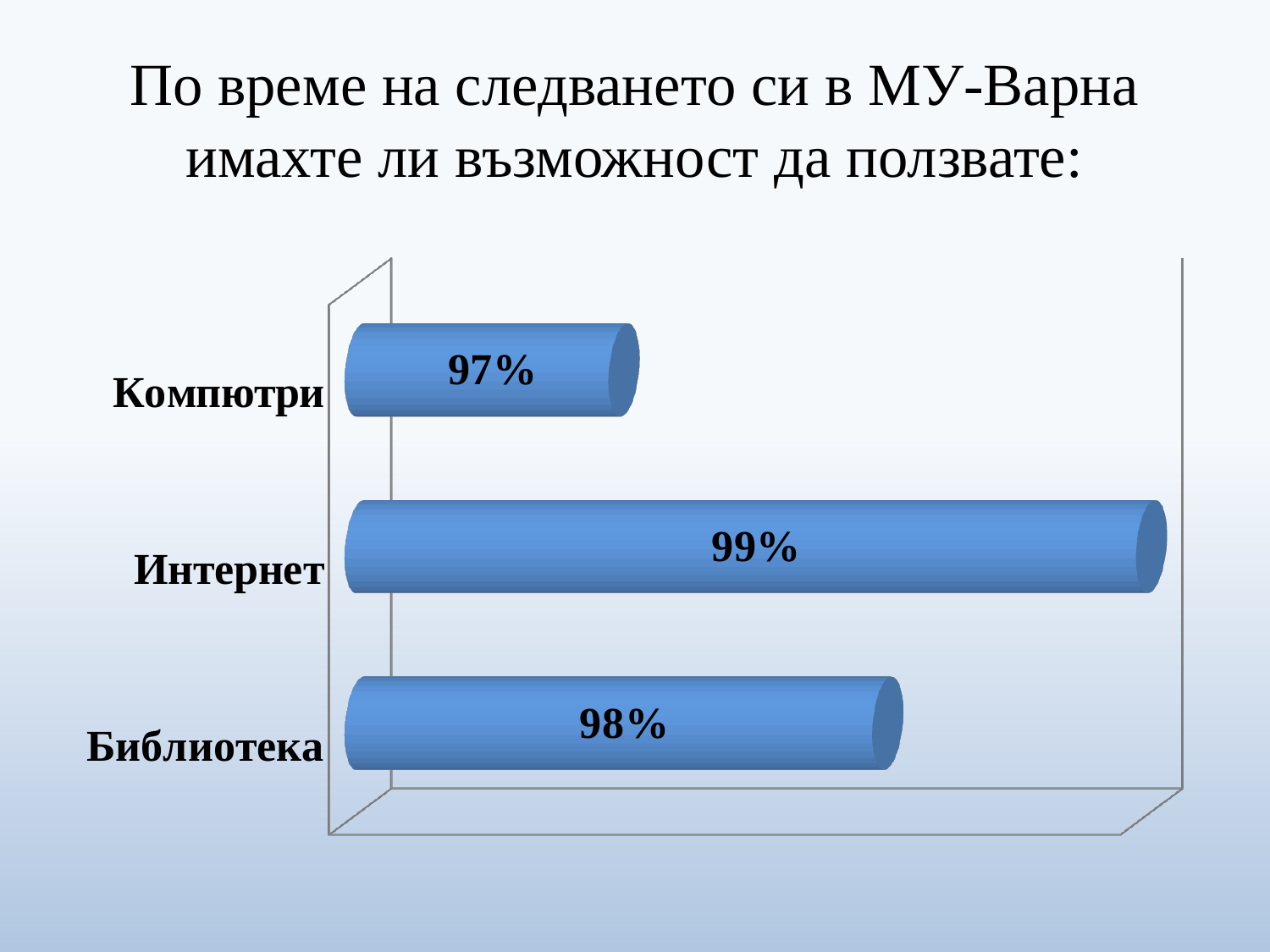
What is the difference between the values for Интернет and Компютри? 2% What is the title of the slide? По време на следването си в МУ-Варна имахте ли възможност да ползвате: Which category has the highest value? Интернет Which is larger, the value for Интернет or the value for Библиотека? Интернет Which is larger, the value for Библиотека or the value for Компютри? Библиотека What kind of chart is shown on the slide? bar chart What is the value for Компютри? 97% What is the value for Интернет? 99% How many categories are shown in the chart? 3 What is the value for Библиотека? 98% Which category has the lowest value? Компютри What is the difference between the values for Библиотека and Компютри? 1%